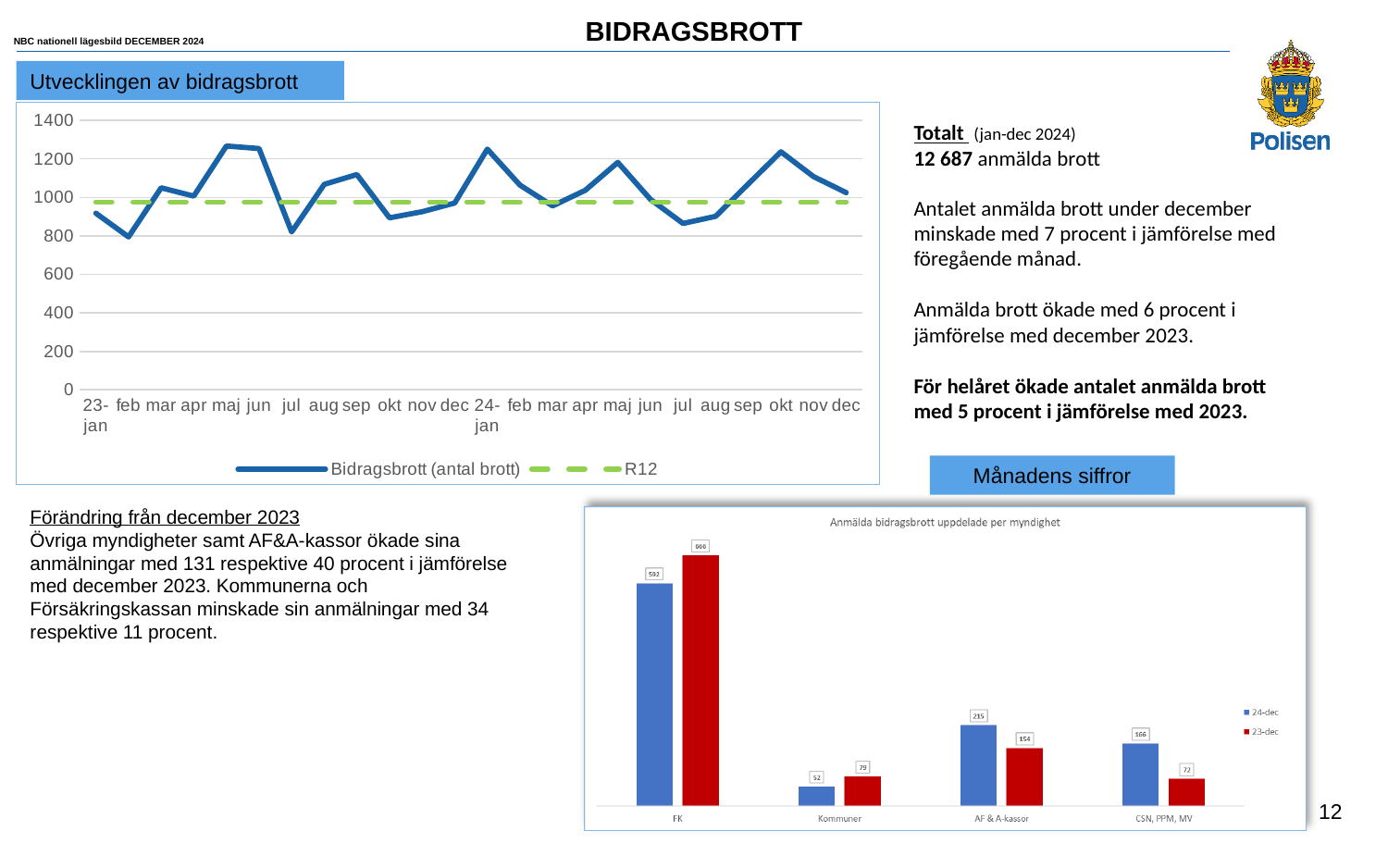
In the chart 'Anmälda bidragsbrott uppdelade per myndighet', what is the value for CSN, PPM, MV in the 23-dec series? 72 How many series does the legend of the chart 'Utvecklingen av bidragsbrott' list? 2 In the chart 'Anmälda bidragsbrott uppdelade per myndighet', what is the difference between the 23-dec and 24-dec values for FK? 74 In the chart 'Utvecklingen av bidragsbrott', is the value of Bidragsbrott (antal brott) for 23-feb greater or less than 1000? less In the chart 'Anmälda bidragsbrott uppdelade per myndighet', which is larger for AF & A-kassor: the 24-dec value or the 23-dec value? 24-dec In the chart 'Anmälda bidragsbrott uppdelade per myndighet', which category has the highest 24-dec value? FK In the chart 'Anmälda bidragsbrott uppdelade per myndighet', which category has the lowest 24-dec value? Kommuner How many categories are shown on the x axis of the chart 'Anmälda bidragsbrott uppdelade per myndighet'? 4 In the chart 'Anmälda bidragsbrott uppdelade per myndighet', what is the value for Kommuner in the 23-dec series? 79 In the chart 'Anmälda bidragsbrott uppdelade per myndighet', what is the value for FK in the 24-dec series? 592 In the chart 'Utvecklingen av bidragsbrott', is the value of Bidragsbrott (antal brott) for 24-jan greater or less than 1000? greater What kind of chart is the chart titled 'Anmälda bidragsbrott uppdelade per myndighet'? Bar chart